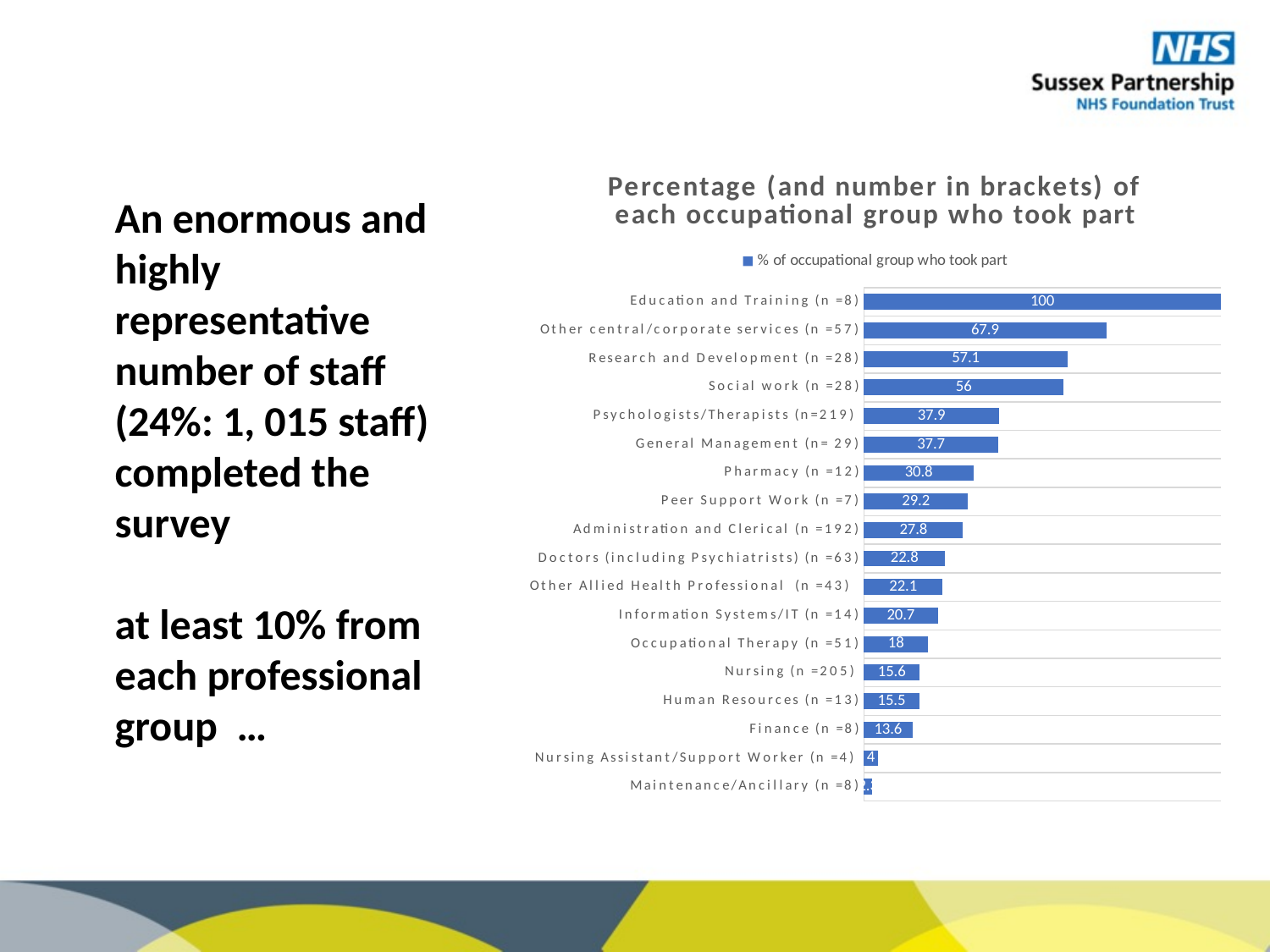
What is the value for Psychologists/Therapists (n=219)? 37.9 Which has a larger value, Pharmacy (n =12) or Doctors (including Psychiatrists) (n =63)? Pharmacy (n =12) How many occupational groups are shown in the chart? 18 What is the value for Education and Training (n =8)? 100 What is the value for Nursing Assistant/Support Worker (n =4)? 4 What type of chart is shown on the slide? Bar chart What is the value for Nursing (n =205)? 15.6 What is the difference between the values for Research and Development (n =28) and Social work (n =28)? 1.1 Which occupational group has the highest percentage who took part? Education and Training (n =8) What is the difference between the values for Education and Training (n =8) and Other central/corporate services (n =57)? 32.1 How many series does the legend list? 1 Which occupational group has the lowest percentage who took part? Maintenance/Ancillary (n =8)